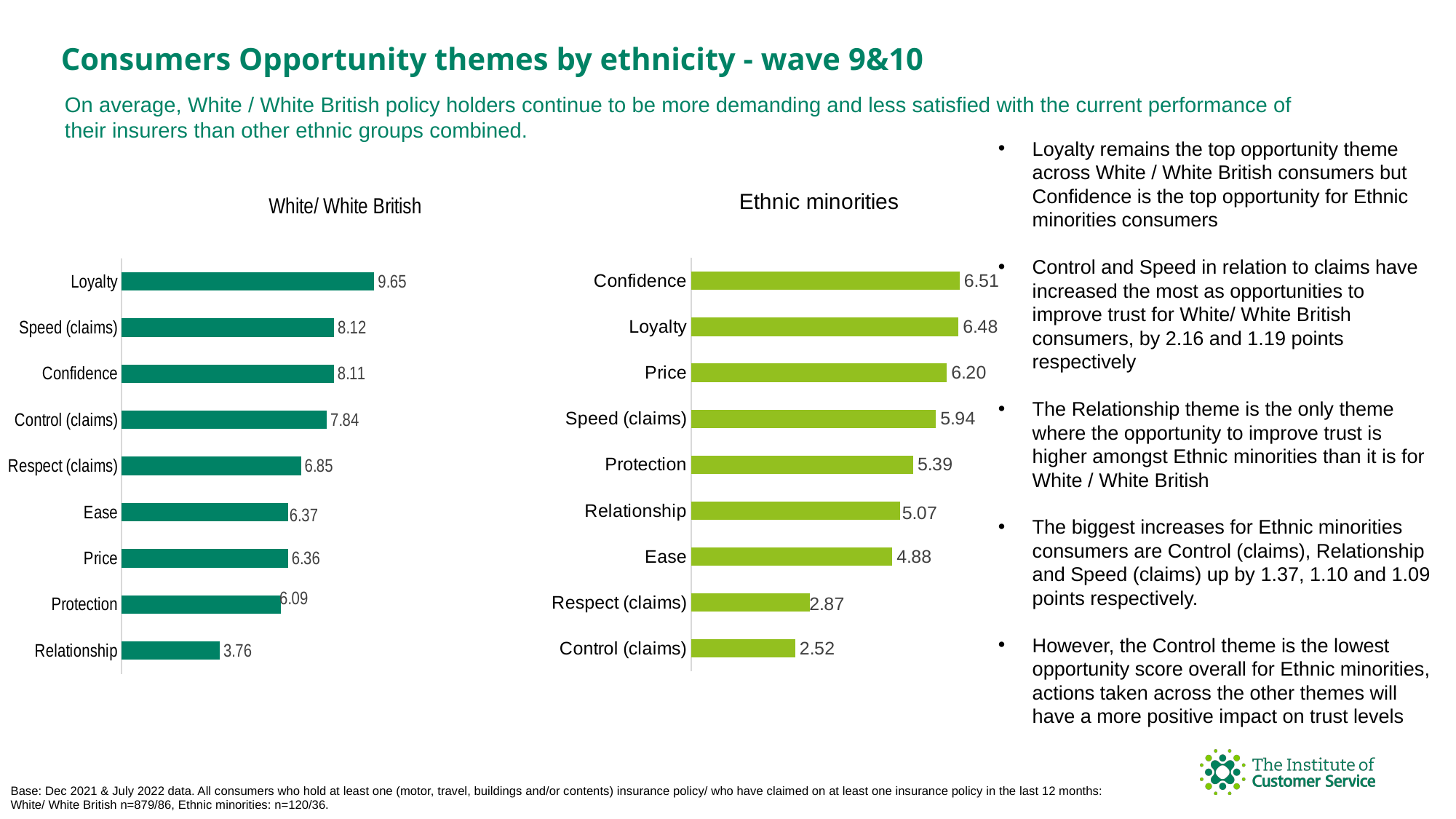
In the White/ White British chart, what is the value for Loyalty? 9.65 In the White/ White British chart, which is larger: Control (claims) or Respect (claims)? Control (claims) What type of chart is the Ethnic minorities chart? Bar chart In the Ethnic minorities chart, what is the value for Price? 6.20 What colour are the bars in the Ethnic minorities chart? Light green In the Ethnic minorities chart, what is the difference between Confidence and Control (claims)? 3.99 In the Ethnic minorities chart, which category has the lowest value? Control (claims) In the Ethnic minorities chart, which category has the highest value? Confidence How many categories are shown in the White/ White British chart? 9 In the Ethnic minorities chart, which is larger: Protection or Ease? Protection In the White/ White British chart, what is the difference between Loyalty and Relationship? 5.89 In the White/ White British chart, which category has the lowest value? Relationship